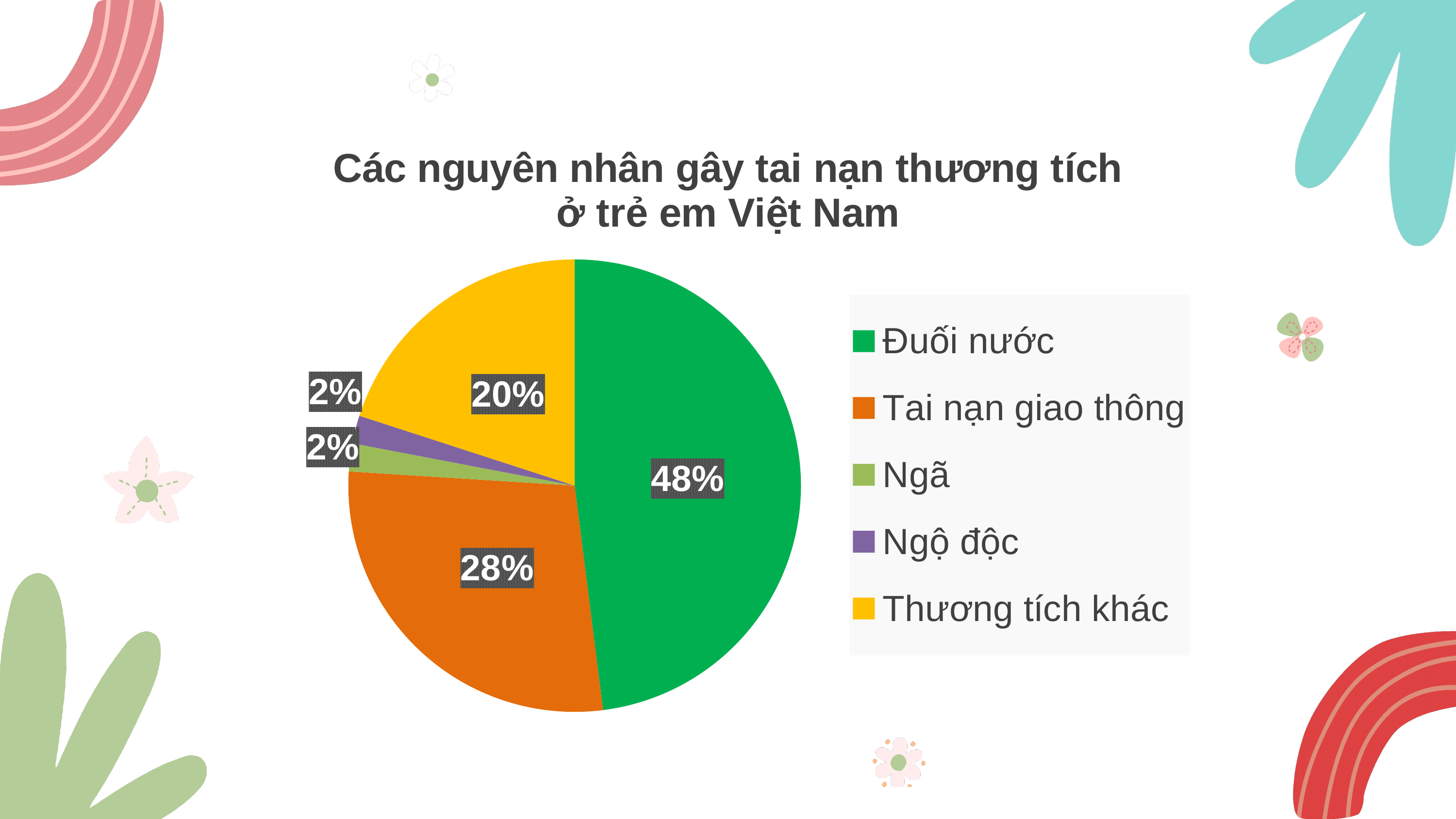
What percentage is shown for Thương tích khác? 20% What type of chart is shown on the slide? Pie chart What percentage of the pie is labelled for Đuối nước? 48% What percentage is shown for Tai nạn giao thông? 28% What percentage is shown for Ngộ độc? 2% What is the difference between the shares of Đuối nước and Tai nạn giao thông? 20% What is the title of the chart? Các nguyên nhân gây tai nạn thương tích ở trẻ em Việt Nam How many categories does the legend list? 5 What is the combined share of Ngã and Ngộ độc? 4% Which category has the largest share of the pie? Đuối nước What colour represents Ngã in the chart? Green (light green) Which is larger, the share for Tai nạn giao thông or the share for Thương tích khác? Tai nạn giao thông